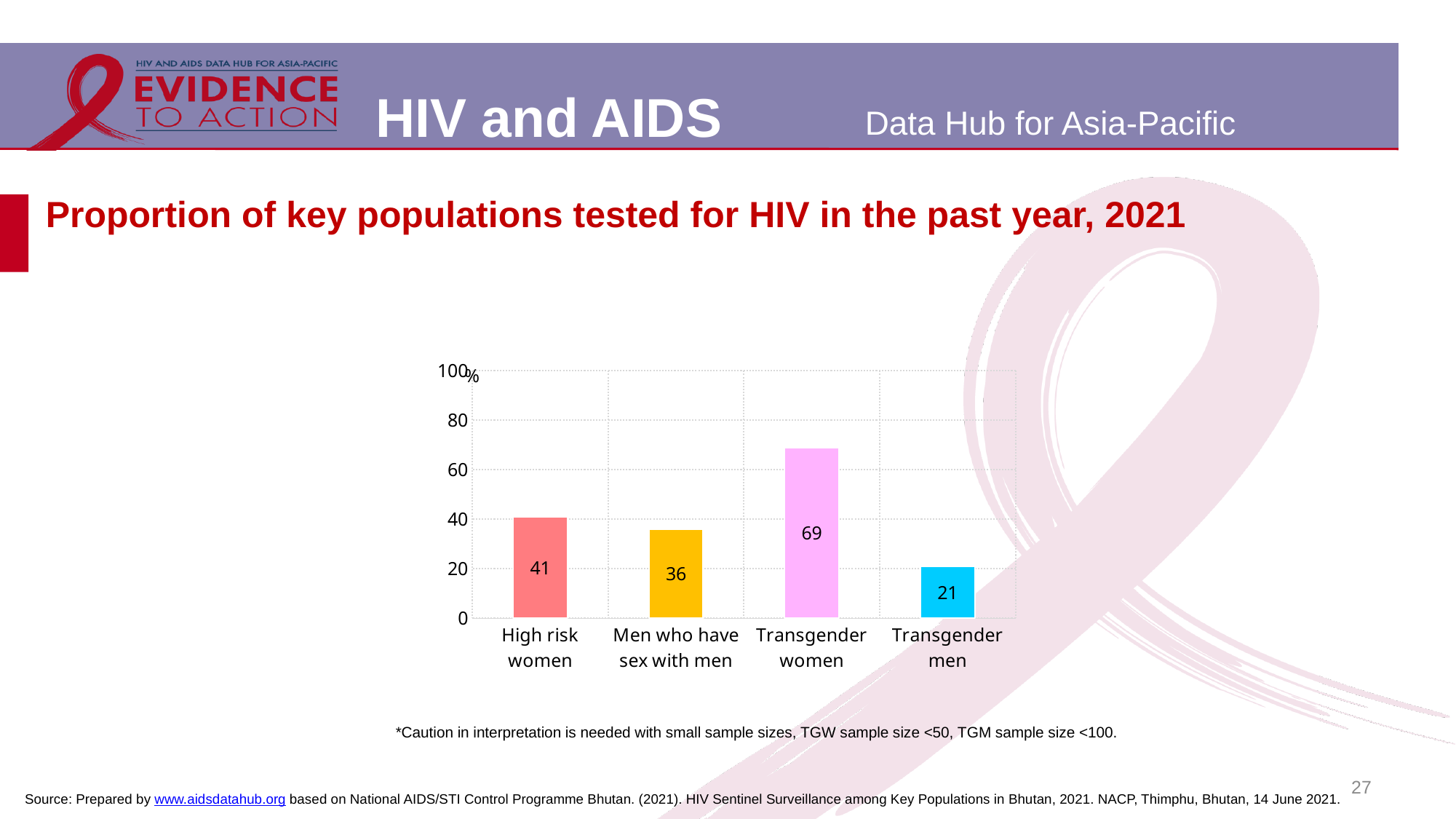
What is the value for Men who have sex with men? 36 What is the value for Transgender men? 21 What kind of chart is shown on the slide? bar chart Which is larger, the value for High risk women or the value for Men who have sex with men? High risk women What is the difference between the values for Transgender women and Transgender men? 48 What is the title of the chart? Proportion of key populations tested for HIV in the past year, 2021 Is the value for Transgender women greater or less than 60? greater How many categories are shown in the chart? 4 Which category has the highest value? Transgender women Which category has the lowest value? Transgender men What is the value for High risk women? 41 What is the value for Transgender women? 69